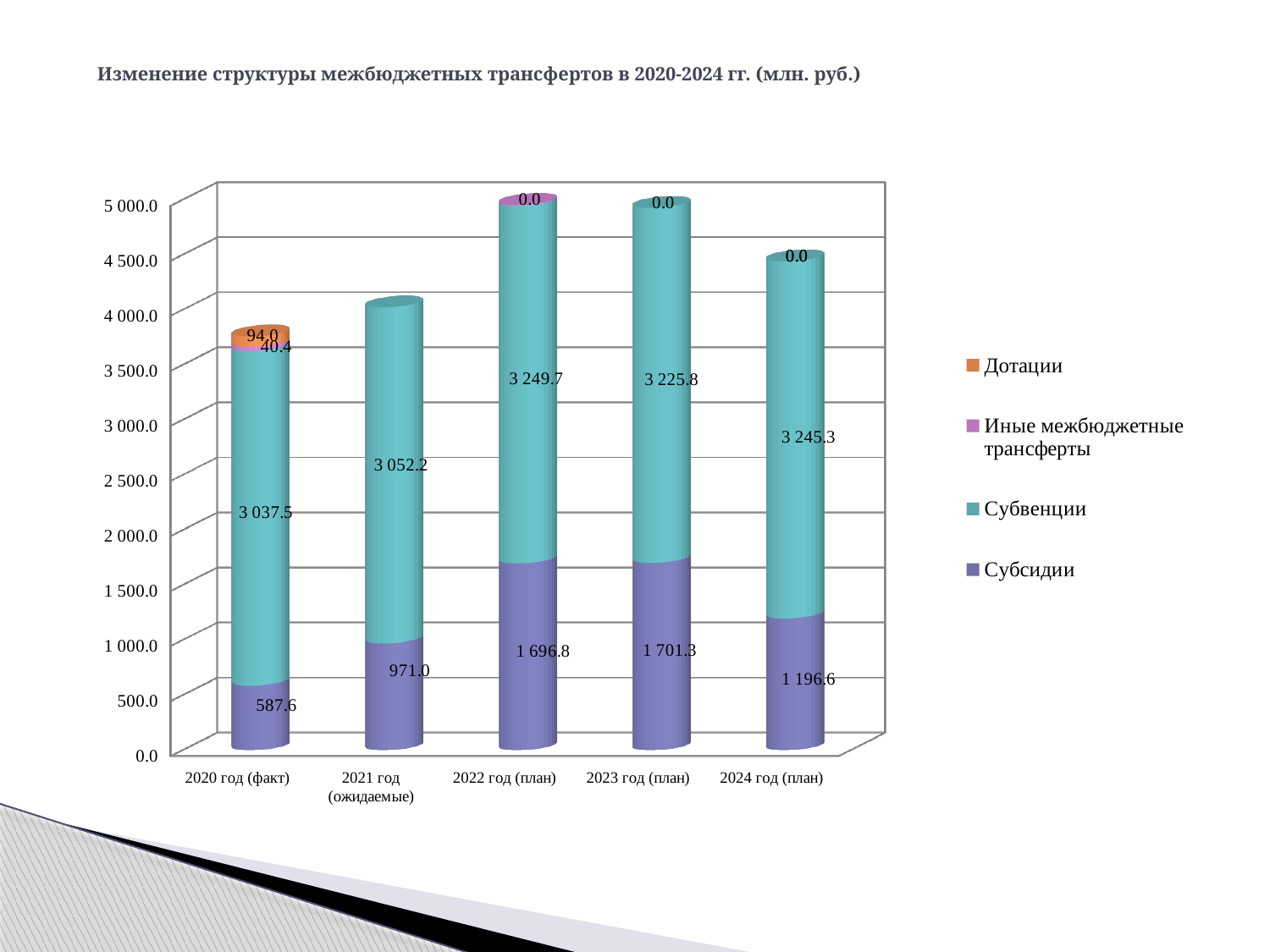
What is the value of Дотации for 2020 год (факт)? 94.0 What kind of chart is shown on the slide? Stacked bar chart What is the difference between Субвенции in 2022 год (план) and 2021 год (ожидаемые)? 197.5 Which year has the highest value of Субсидии? 2023 год (план) What is the value of Субсидии for 2024 год (план)? 1 196.6 What is the value of Субсидии for 2020 год (факт)? 587.6 What is the total of the stacked bar for 2020 год (факт)? 3 759.5 Which is larger: Субсидии in 2022 год (план) or Субсидии in 2024 год (план)? 2022 год (план) How many series does the legend list? 4 Which year has the lowest value of Субсидии? 2020 год (факт) Is the total of the stacked bar for 2024 год (план) greater or less than 4 000.0? greater What is the value of Субвенции for 2022 год (план)? 3 249.7